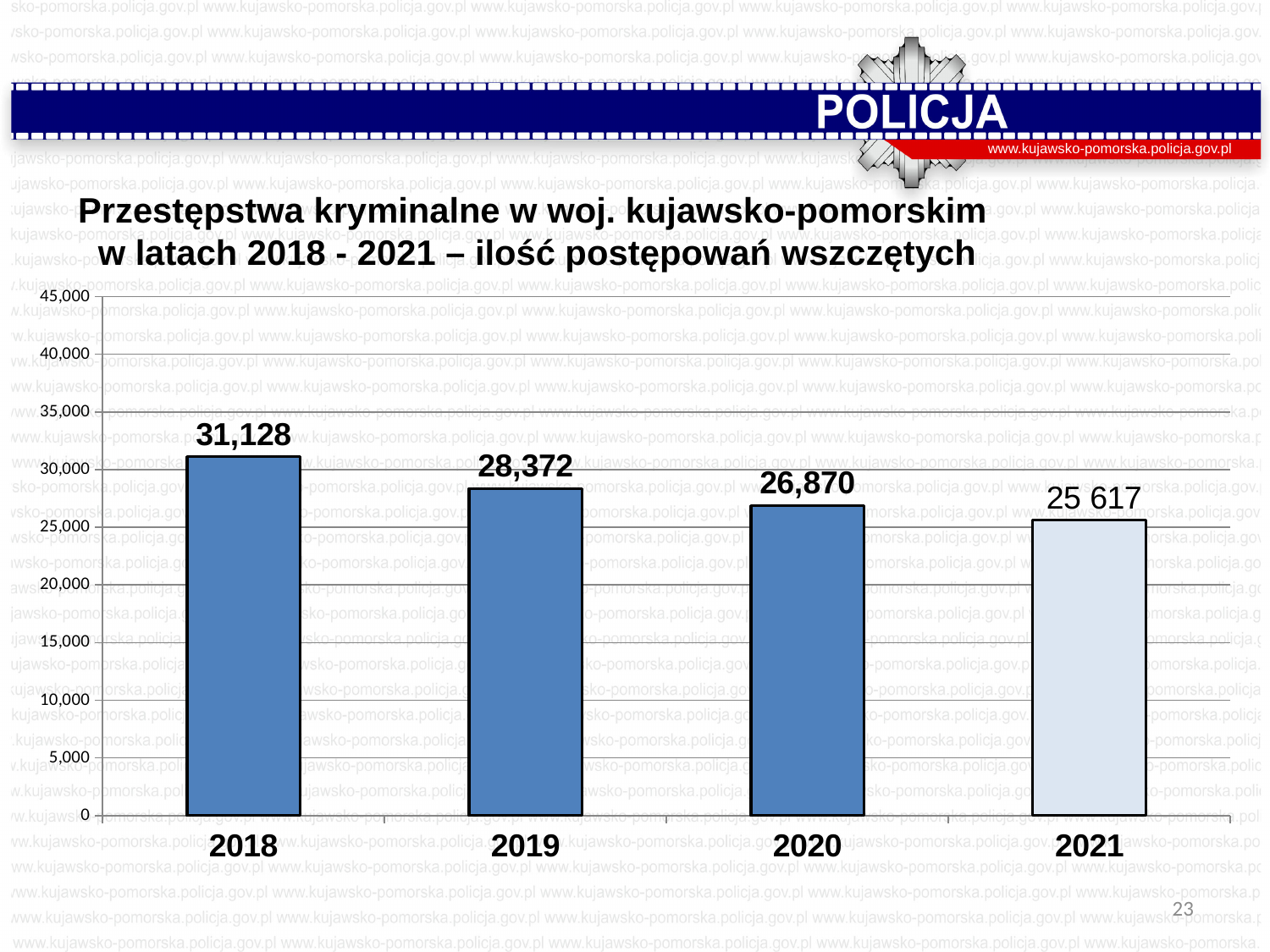
What is the difference between the values for 2018 and 2019? 2,756 What is the value for 2018? 31,128 Is the value for 2018 greater or less than 30,000? greater Do the values rise or fall from 2018 to 2021? fall Which is larger, the value for 2020 or the value for 2021? 2020 What is the value for 2020? 26,870 What is the difference between the values for 2019 and 2020? 1,502 How many years are shown on the x axis? 4 What is the value for 2021? 25 617 What is the value for 2019? 28,372 Which year has the highest value? 2018 Which year has the lowest value? 2021